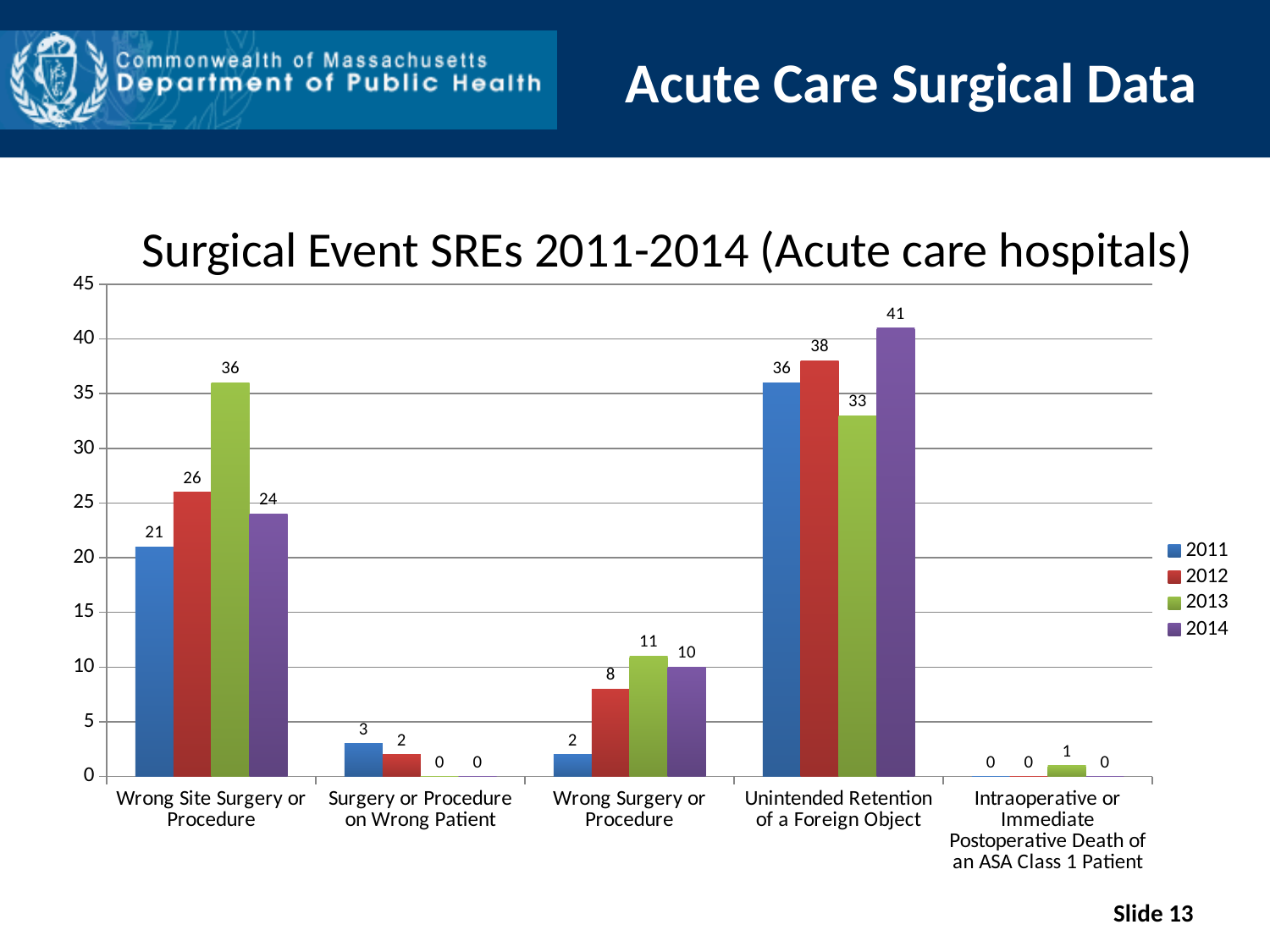
What is the value for Wrong Site Surgery or Procedure in 2013? 36 What is the value for Wrong Surgery or Procedure in 2012? 8 What is the difference between the 2013 and 2011 values for Wrong Site Surgery or Procedure? 15 Which is larger for Wrong Surgery or Procedure: the 2013 value or the 2014 value? 2013 How many series does the legend list? 4 Is the value for Unintended Retention of a Foreign Object in 2012 greater or less than 35? greater Which category has the highest value in 2011? Unintended Retention of a Foreign Object How many categories are shown on the x axis? 5 Which year has the lowest value for Unintended Retention of a Foreign Object? 2013 What is the title of the chart? Surgical Event SREs 2011-2014 (Acute care hospitals) What kind of chart is shown on the slide? Bar chart What is the value for Unintended Retention of a Foreign Object in 2014? 41